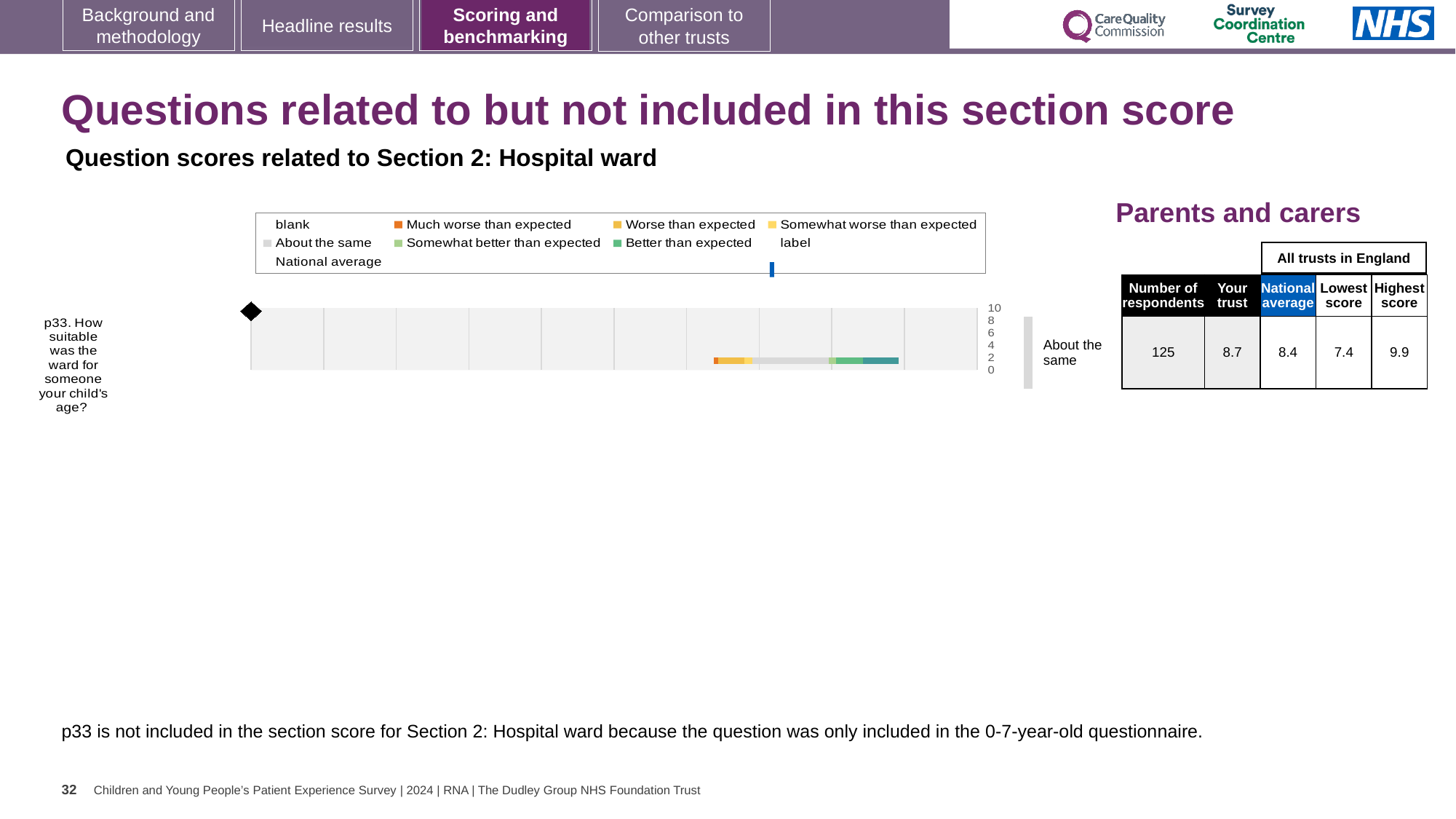
What is the lowest score among all trusts in England for question p33? 7.4 Which legend entry is shown in orange? Much worse than expected What is the difference between the highest and lowest trust scores for question p33? 2.5 What is the 'Your trust' score for question p33? 8.7 Which is larger for question p33: the 'Your trust' score or the national average? Your trust What is the national average score for question p33? 8.4 What is the difference between the 'Your trust' score and the national average for question p33? 0.3 How many respondents answered question p33? 125 What benchmark category is shown next to the chart for question p33? About the same How many questions are plotted in the chart? 1 What kind of chart is used to show the result for question p33? bar chart What is the highest score among all trusts in England for question p33? 9.9